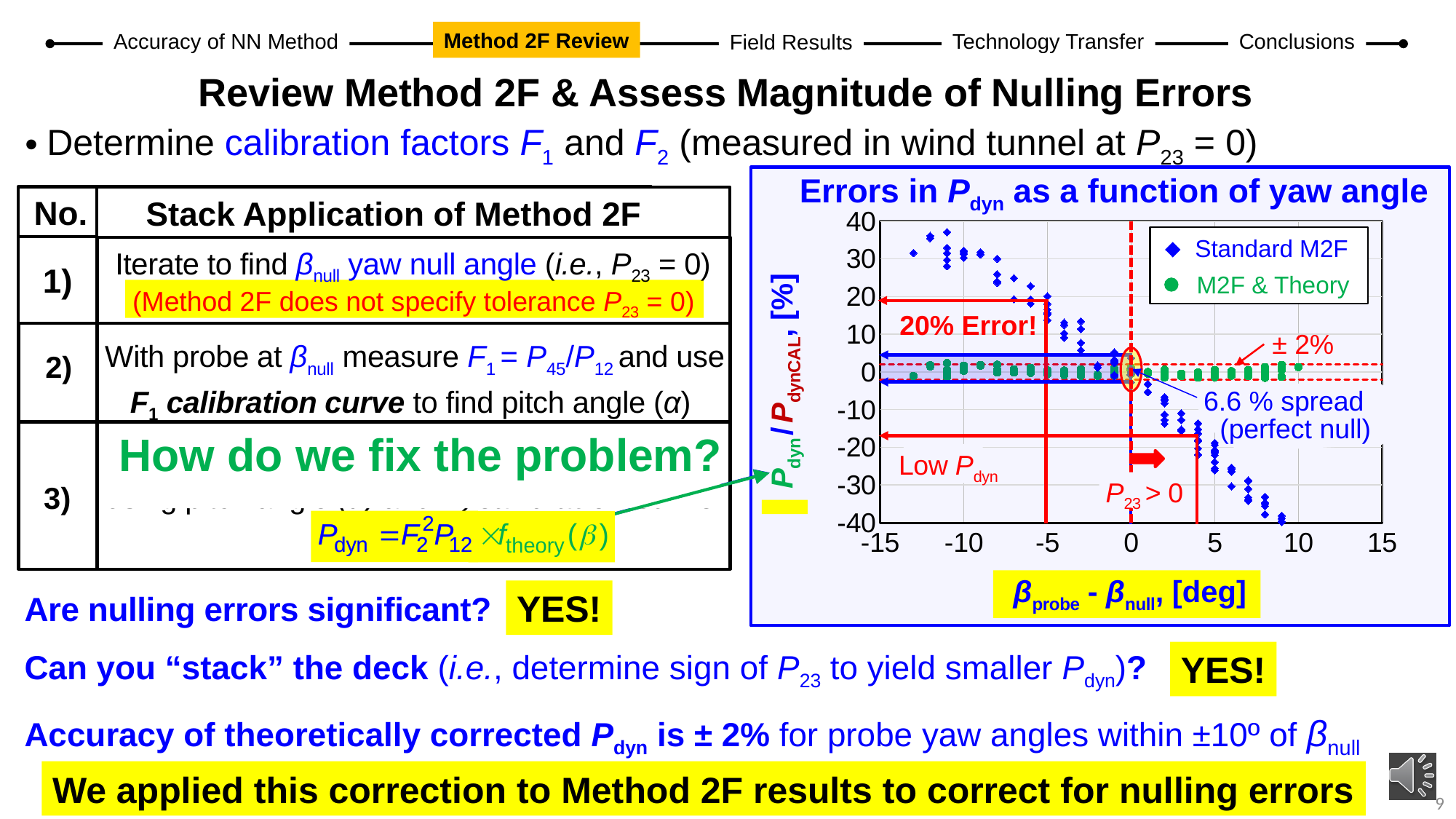
At a yaw angle of 8 degrees, which series has the larger value, Standard M2F or M2F & Theory? M2F & Theory What type of chart is shown on the slide? scatter chart Do the Standard M2F values rise or fall as the yaw angle increases from -15 to 15 degrees? fall Is the Standard M2F value at a yaw angle of 10 degrees greater or less than -20? less What is the maximum value shown on the chart's y axis? 40 Is the Standard M2F value at a yaw angle of -10 degrees greater or less than 20? greater How many series does the chart legend list? 2 Is the M2F & Theory value at a yaw angle of -10 degrees greater or less than -10? greater What are the two series named in the chart legend? Standard M2F and M2F & Theory What is the title of the chart? Errors in Pdyn as a function of yaw angle At a yaw angle of -5 degrees, which series has the larger value, Standard M2F or M2F & Theory? Standard M2F